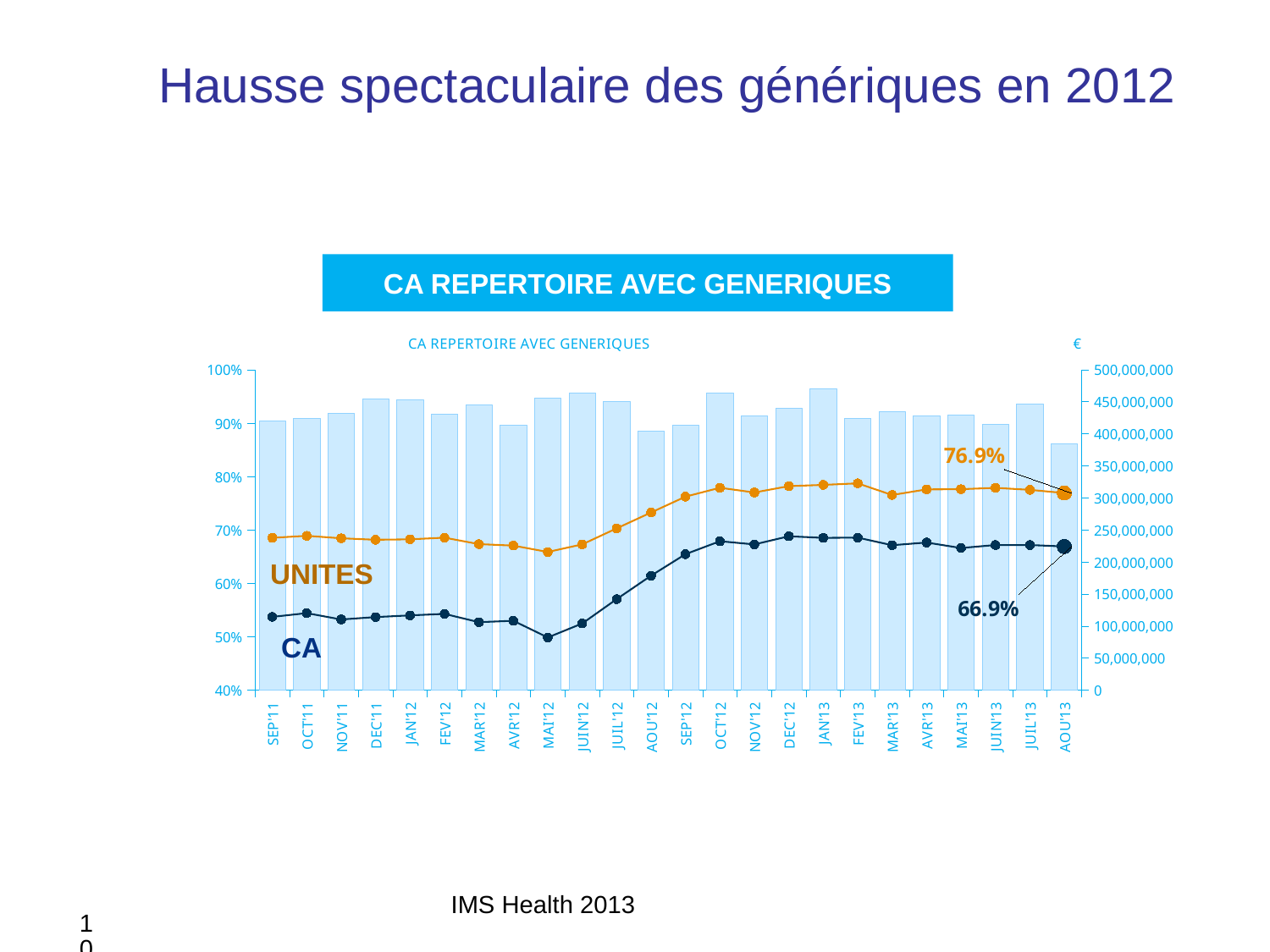
Is the CA value at MAI'12 greater or less than 60%? less What is the title of the chart? CA REPERTOIRE AVEC GENERIQUES At AOU'13, which series has the higher value, UNITES or CA? UNITES Is the UNITES value at SEP'11 greater or less than 60%? greater What is the UNITES value at AOU'13? 76.9% Does the CA line rise or fall between MAI'12 and OCT'12? Rise At AOU'13, what is the difference between the UNITES value and the CA value? 10.0% What kind of chart is this? Combined bar and line chart How many months are shown on the x axis? 24 In which month is the CA line at its lowest? MAI'12 Is the bar value for MAI'12 greater or less than 400,000,000? greater What is the CA value at AOU'13? 66.9%